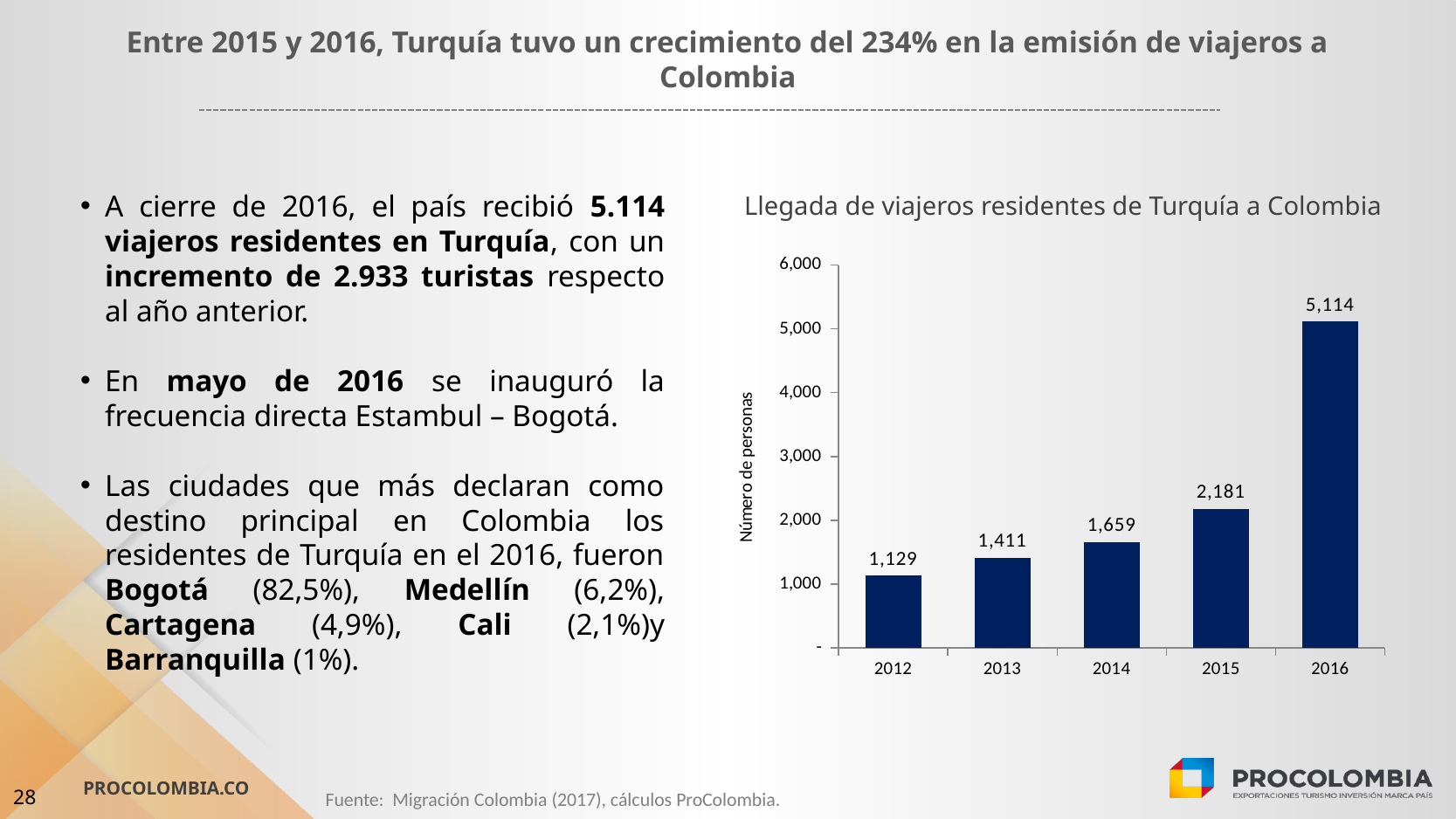
How many years are shown on the x axis of the chart? 5 What is the difference between the values for 2016 and 2015? 2,933 What is the difference between the values for 2013 and 2012? 282 What is the value for 2016 in the chart? 5,114 Which year has the lowest value in the chart? 2012 Which is larger, the value for 2015 or the value for 2014? 2015 What is the value for 2014 in the chart? 1,659 Do the values rise or fall from 2012 to 2016? rise What is the value for 2012 in the chart? 1,129 Is the value for 2015 greater or less than 2,000? greater What kind of chart is shown on the slide? bar chart Which year has the highest value in the chart? 2016